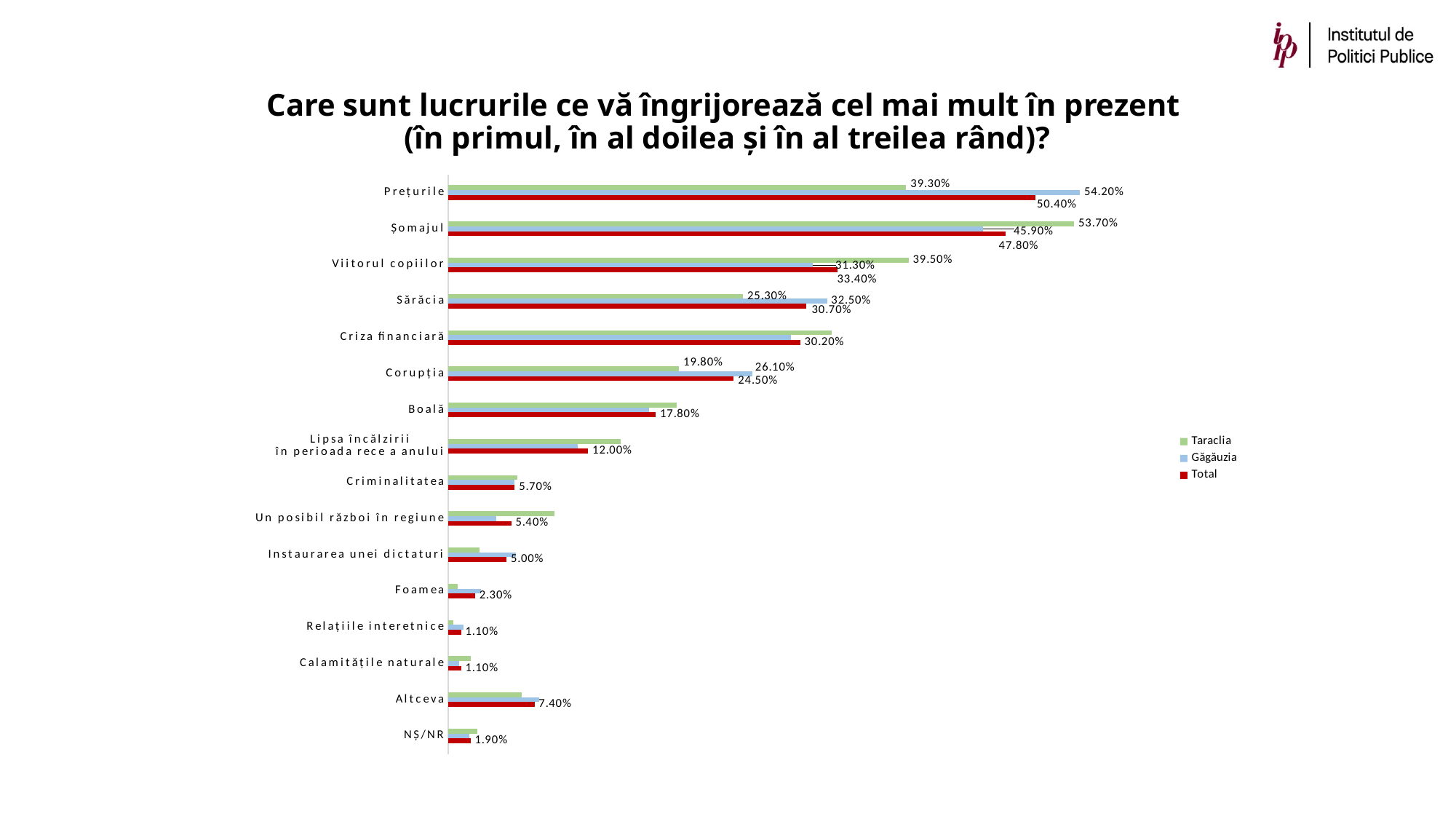
What kind of chart is shown on the slide? Bar chart What is the Găgăuzia value for Prețurile? 54.20% What is the Total value for Corupția? 24.50% For Viitorul copiilor, which is larger: the Taraclia value or the Găgăuzia value? Taraclia How many categories are plotted on the chart? 16 What is the Taraclia value for Șomajul? 53.70% Which category has the highest Total value? Prețurile What is the Total value for Prețurile? 50.40% For Sărăcia, which is larger: the Taraclia value or the Găgăuzia value? Găgăuzia What is the difference between the Găgăuzia and Taraclia values for Prețurile? 14.90 percentage points How many series does the legend list? 3 What are the three series named in the legend? Taraclia, Găgăuzia, Total